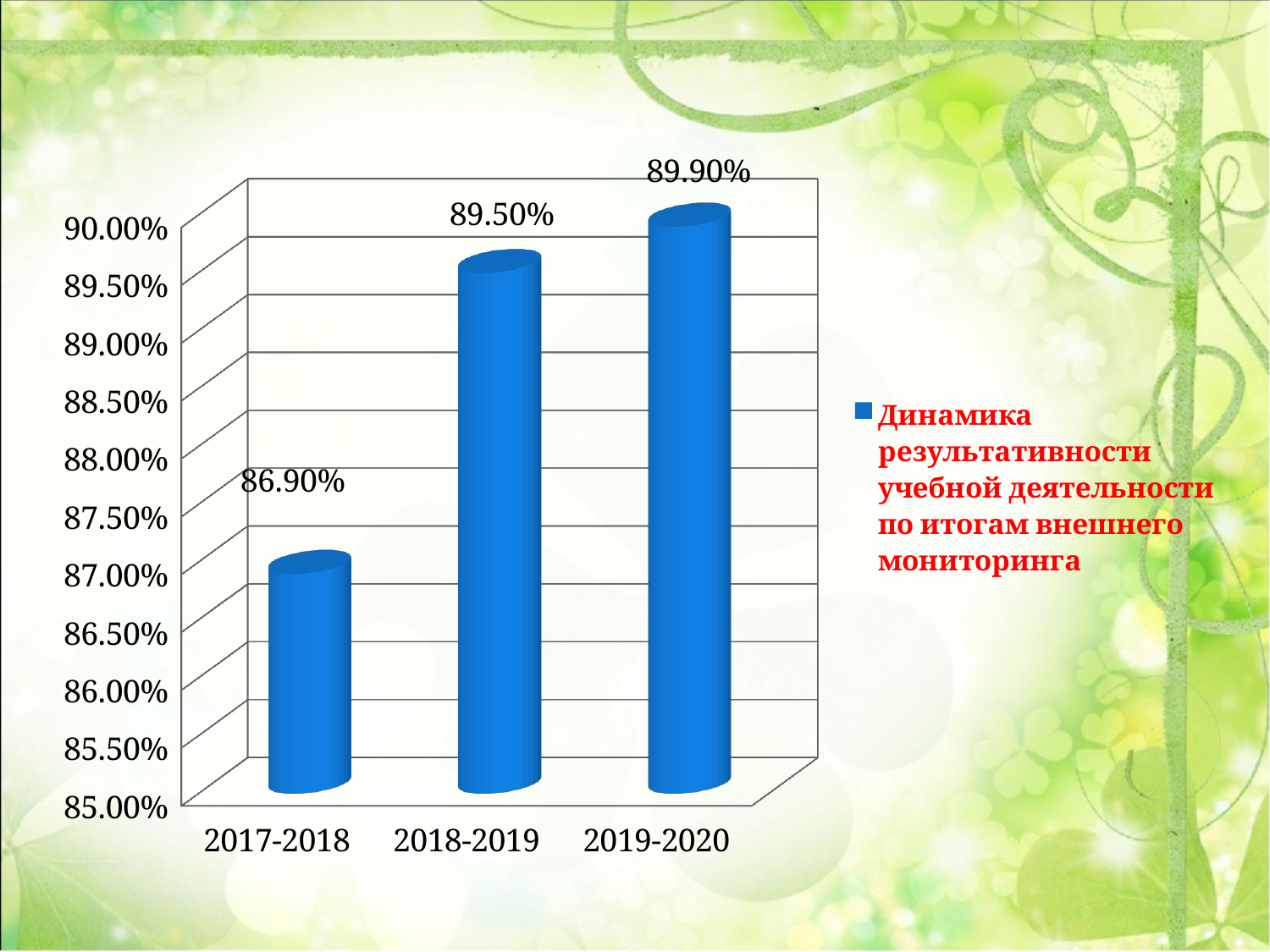
Do the values rise or fall from 2017-2018 to 2019-2020? rise What is the value for 2017-2018? 86.90% Is the value for 2017-2018 greater or less than 87.00%? less What is the difference between the values for 2019-2020 and 2017-2018? 3.00% Which year has the highest value? 2019-2020 How many categories are shown on the x axis? 3 Which year has the lowest value? 2017-2018 What kind of chart is shown on the slide? bar chart Which is larger, the value for 2018-2019 or the value for 2017-2018? 2018-2019 What is the difference between the values for 2018-2019 and 2017-2018? 2.60% What is the value for 2018-2019? 89.50% What is the value for 2019-2020? 89.90%